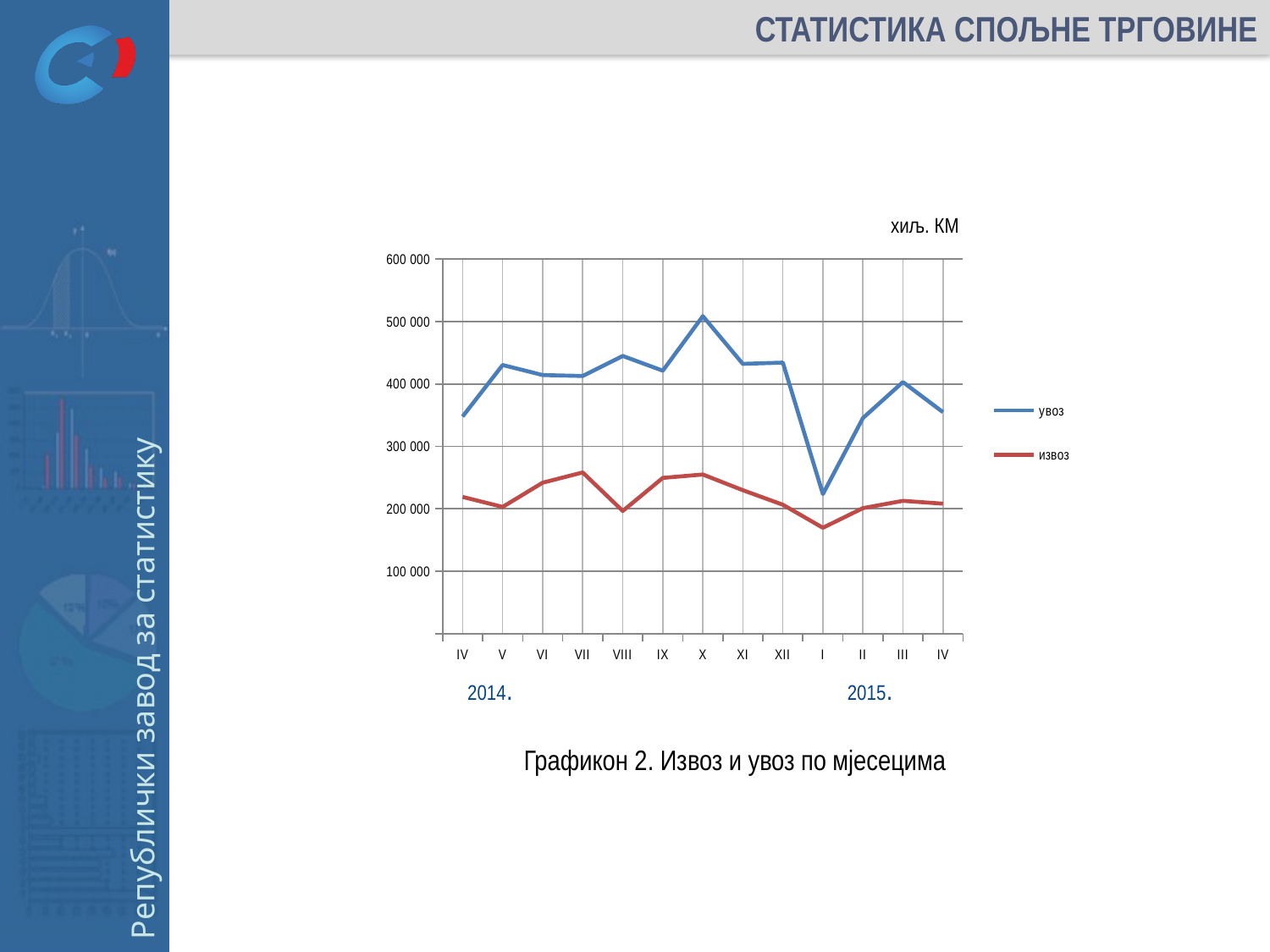
In which month is the увоз (blue) line at its lowest? I 2015 In which month is the увоз (blue) line at its highest? X 2014 What unit label is shown above the chart? хиљ. КМ Is the value of извоз for VII 2014 greater or less than 200 000? greater In which month is the извоз (red) line at its lowest? I 2015 How many series does the legend list? 2 Which is larger in X 2014, увоз or извоз? увоз What kind of chart is shown on the slide? line chart Is the value of увоз for VIII 2014 greater or less than 400 000? greater Is the value of увоз for I 2015 greater or less than 300 000? less Does the увоз line rise or fall from XII 2014 to I 2015? fall How many months (points) are plotted along the x axis? 13